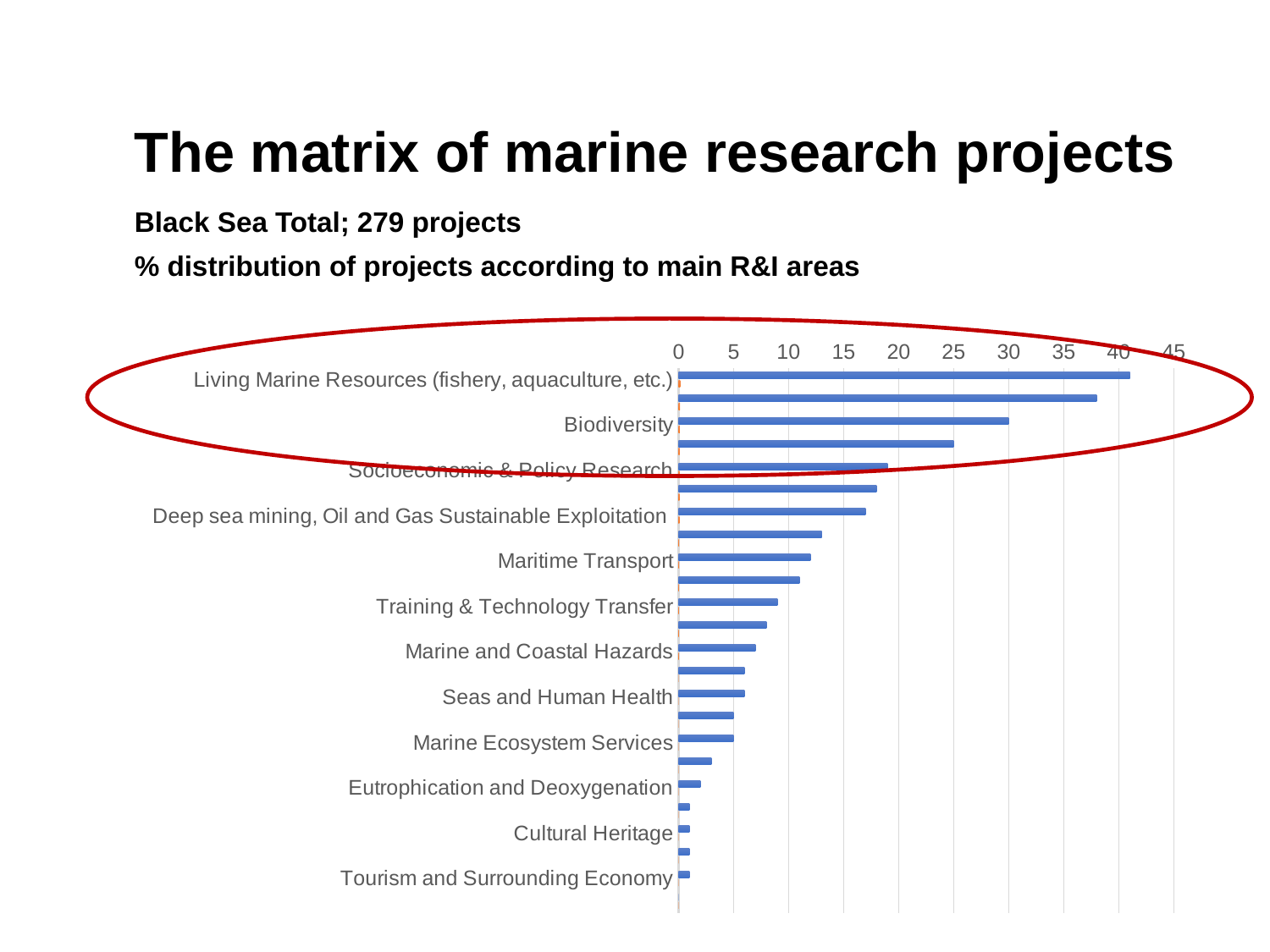
Is the value for Eutrophication and Deoxygenation greater or less than 5? less Is the value for Training & Technology Transfer greater or less than 10? less What is the highest tick value shown on the horizontal axis? 45 Is the value for Socioeconomic & Policy Research greater or less than 20? less Do the bar lengths increase or decrease going from the top of the chart to the bottom? decrease Which is larger, the value for Biodiversity or the value for Maritime Transport? Biodiversity Which labelled category has the longest bar? Living Marine Resources (fishery, aquaculture, etc.) What kind of chart is shown on the slide? bar chart